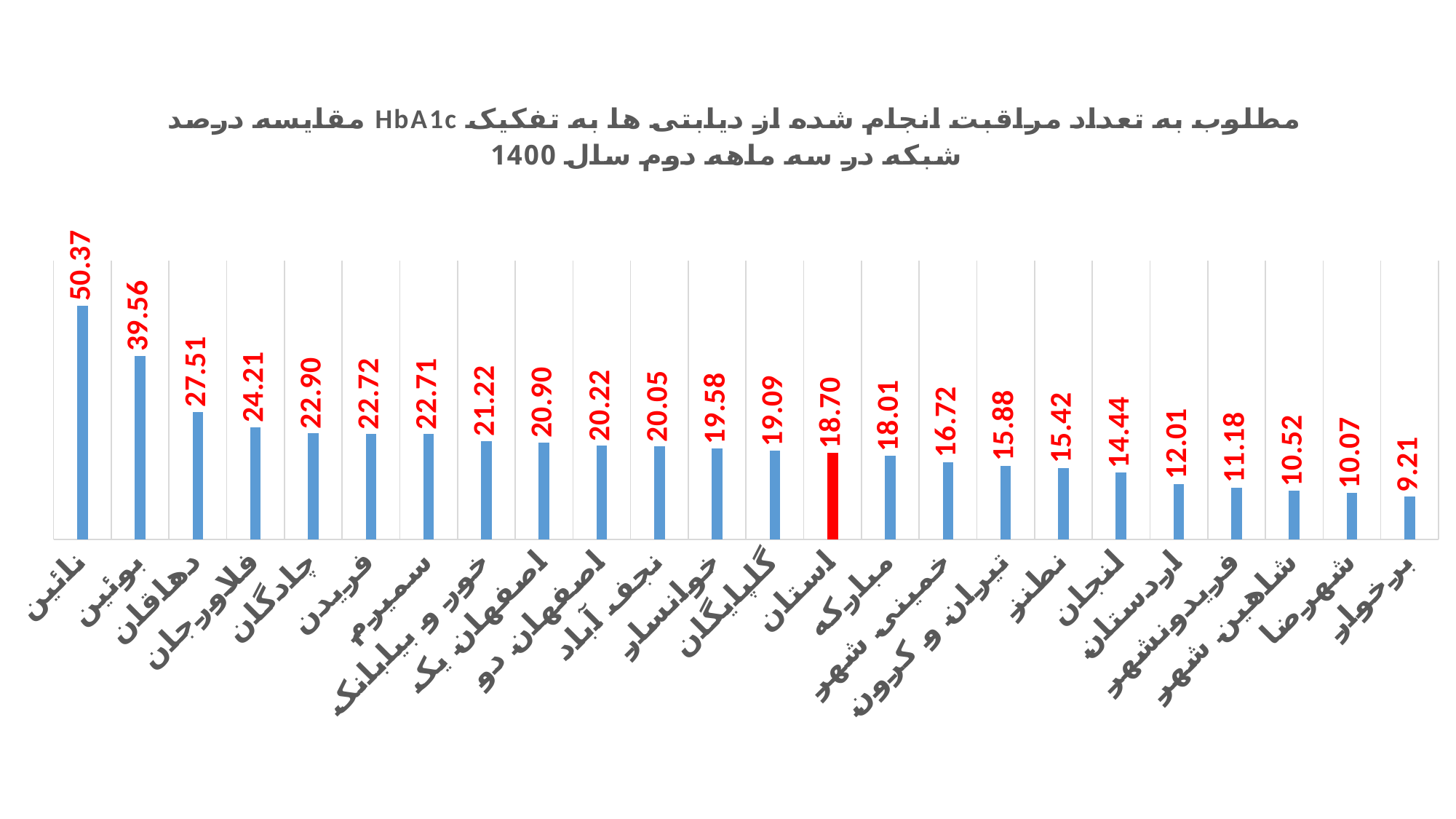
Which is larger, the value for دهاقان or the value for لنجان? دهاقان Which category has the lowest value? برخوار Which category has the highest value? نائین What is the value for خمینی شهر? 16.72 What is the difference between the values for استان and مبارکه? 0.69 What is the value for استان (the red bar)? 18.70 Which bar is coloured red instead of blue? استان What type of chart is shown on the slide? bar chart What is the value for برخوار? 9.21 What is the difference between the values for نائین and بوئین? 10.81 What is the value for نائین? 50.37 How many categories are shown on the x axis? 24